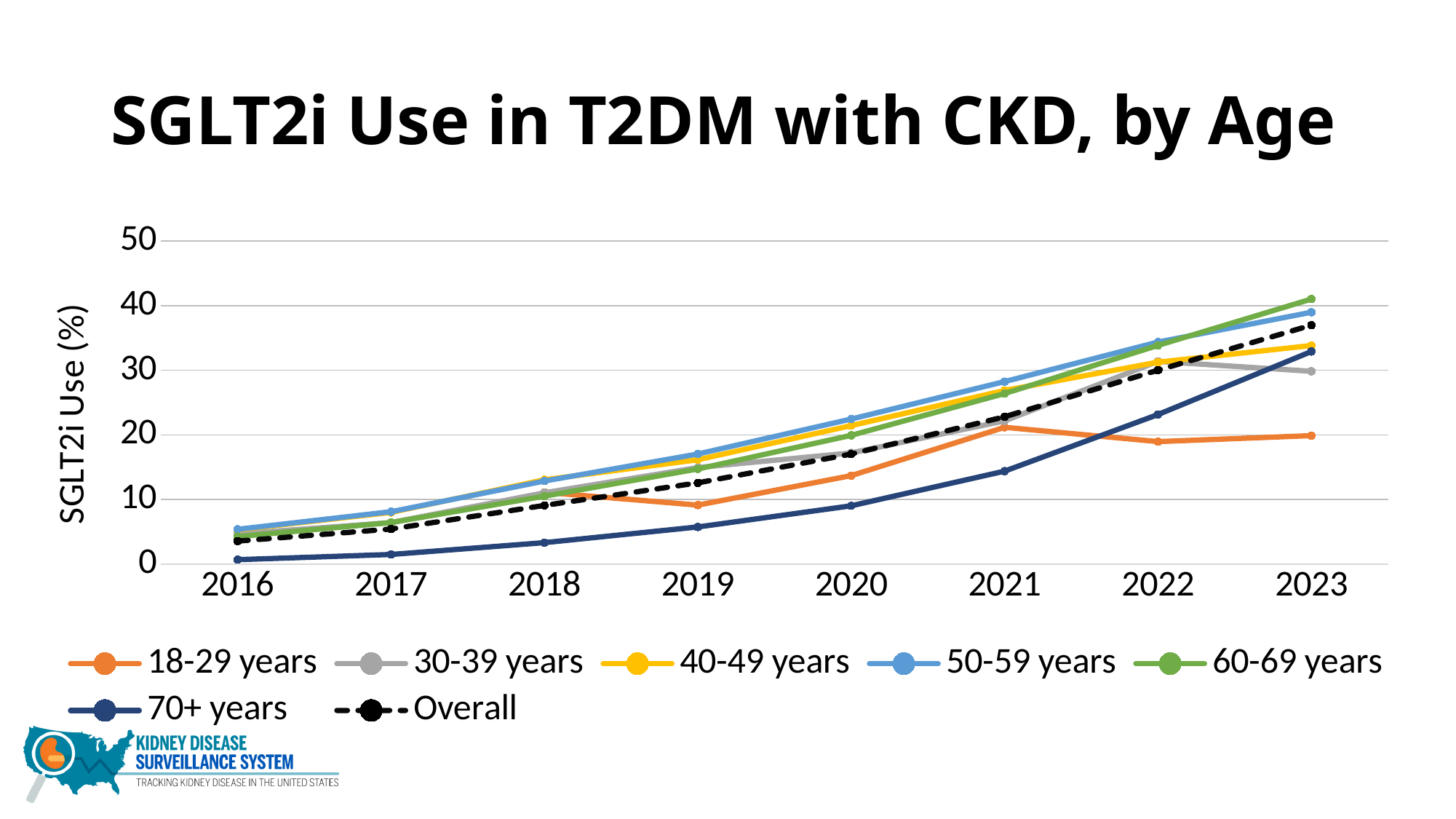
What is the title of the chart? SGLT2i Use in T2DM with CKD, by Age How many series does the legend list? 7 Is the value for Overall in 2023 greater or less than 30? greater What kind of chart is shown on the slide? line chart Is the value for 18-29 years in 2023 greater or less than 30? less Which age group has the highest SGLT2i use in 2023? 60-69 years Does the value for 70+ years rise or fall from 2016 to 2023? rise Which age group has the lowest SGLT2i use in 2023? 18-29 years Which age group has the lowest SGLT2i use in 2016? 70+ years What is the label on the y axis? SGLT2i Use (%) How many years are shown along the x axis? 8 Is the value for 70+ years in 2019 greater or less than 10? less